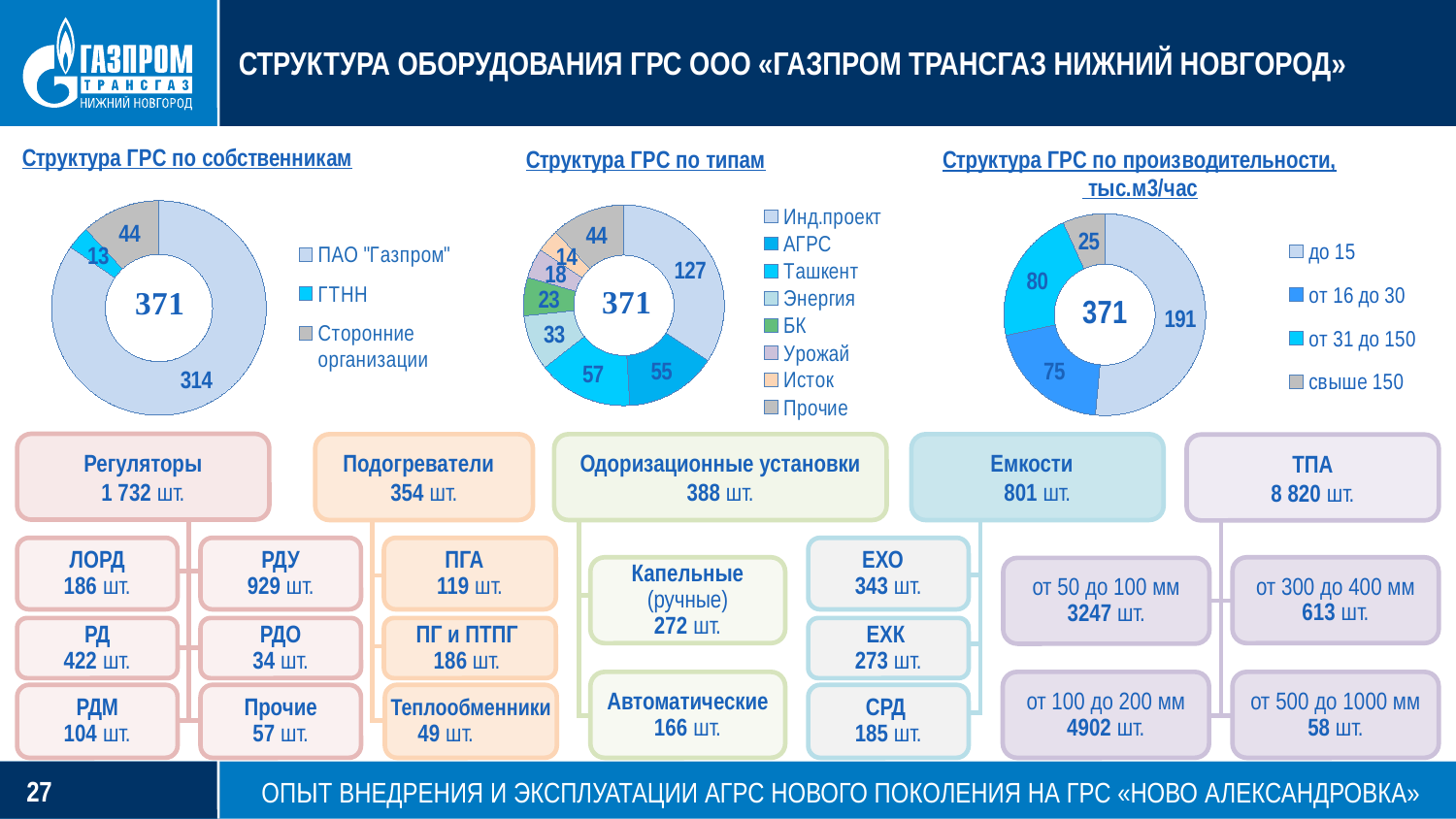
In the chart "Структура ГРС по производительности, тыс.м3/час", what is the difference between до 15 and свыше 150? 166 In the chart "Структура ГРС по производительности, тыс.м3/час", what is the value for до 15? 191 In the chart "Структура ГРС по типам", what is the value for Инд.проект? 127 In the chart "Структура ГРС по собственникам", which category has the lowest value? ГТНН In the chart "Структура ГРС по типам", what is the value for БК? 23 In the chart "Структура ГРС по производительности, тыс.м3/час", which is larger: от 16 до 30 or от 31 до 150? от 31 до 150 What type of chart is "Структура ГРС по собственникам"? Doughnut chart In the chart "Структура ГРС по типам", what is the difference between Ташкент and АГРС? 2 In the chart "Структура ГРС по типам", which category has the lowest value? Исток In the chart "Структура ГРС по собственникам", what is the value for ПАО "Газпром"? 314 In the chart "Структура ГРС по собственникам", what is the value for Сторонние организации? 44 In the chart "Структура ГРС по типам", how many categories does the legend list? 8